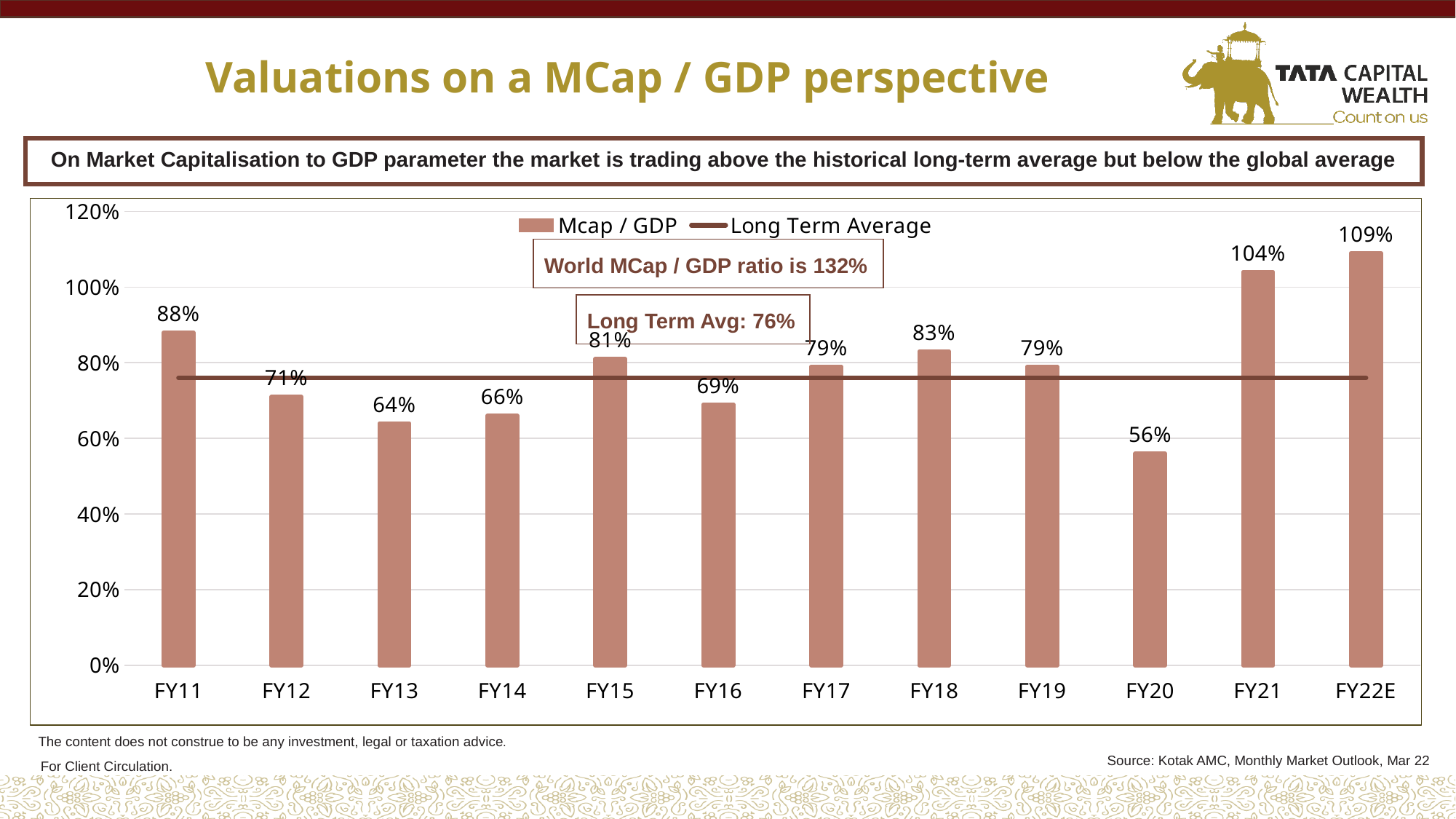
What is the difference between the Mcap / GDP values for FY21 and FY20? 48% Is the Mcap / GDP value for FY18 greater or less than 80%? greater What is the Mcap / GDP value for FY11? 88% What is the Long Term Avg value stated in the text box on the chart? 76% What is the Mcap / GDP value for FY20? 56% Which fiscal year has the lowest Mcap / GDP value? FY20 How many fiscal years are shown on the x axis? 12 What is the Mcap / GDP value for FY22E? 109% How many series does the legend list? 2 What kind of chart is shown on the slide? combination bar and line chart Which is larger, the Mcap / GDP value for FY15 or FY16? FY15 Which fiscal year has the highest Mcap / GDP value? FY22E